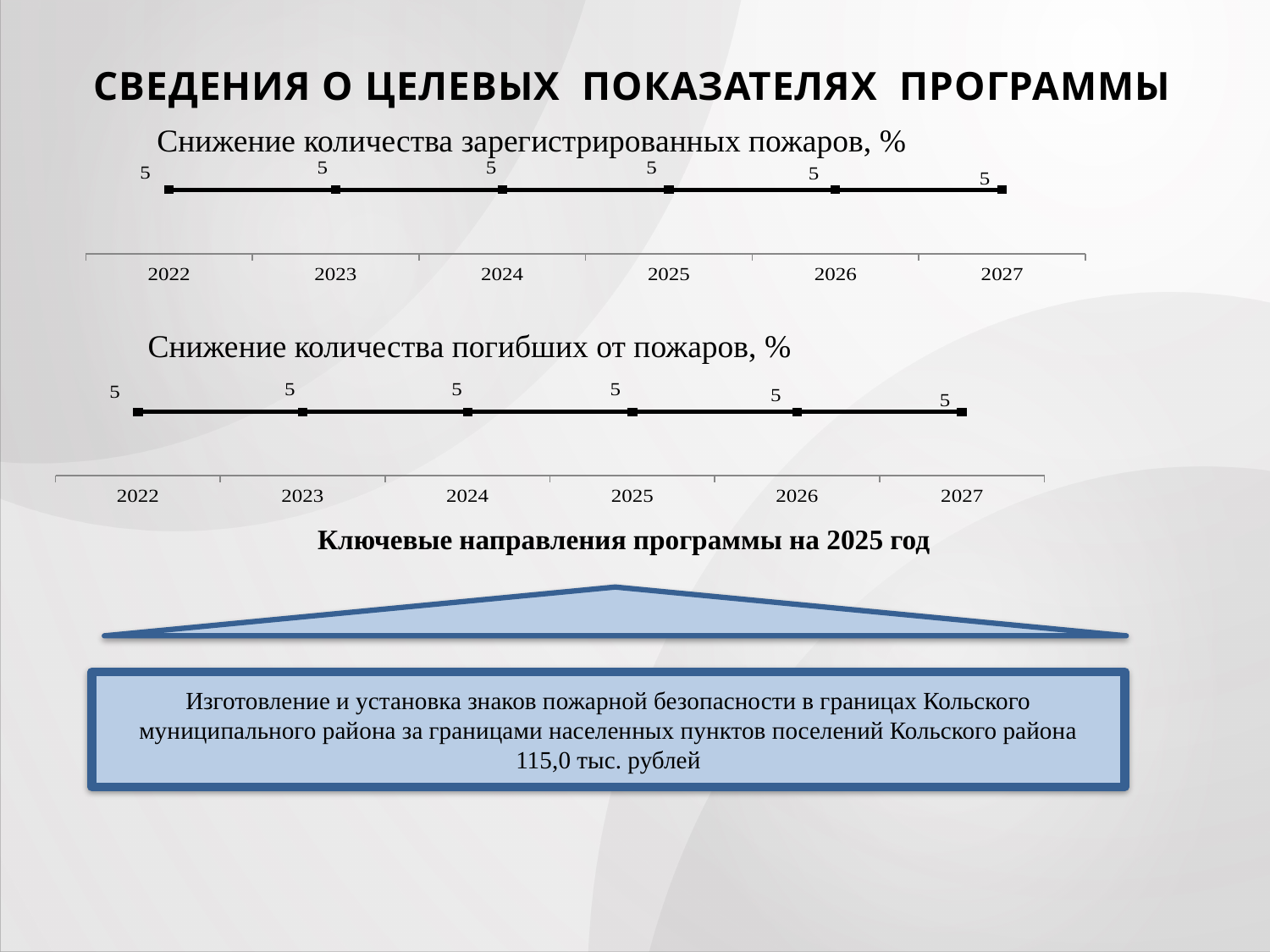
In the top chart ("Снижение количества зарегистрированных пожаров, %"), what is the value for 2022? 5 In the bottom chart ("Снижение количества погибших от пожаров, %"), what is the value for 2025? 5 In the bottom chart ("Снижение количества погибших от пожаров, %"), what is the difference between the values for 2023 and 2026? 0 How many years are shown on the x axis of the chart titled "Снижение количества погибших от пожаров, %"? 6 In the top chart ("Снижение количества зарегистрированных пожаров, %"), what is the difference between the values for 2027 and 2022? 0 In the chart titled "Снижение количества зарегистрированных пожаров, %", what is the value for 2024? 5 What is the first year shown on the x axis of the bottom chart, "Снижение количества погибших от пожаров, %"? 2022 How many data points are plotted in the chart titled "Снижение количества зарегистрированных пожаров, %"? 6 Do the values in the chart titled "Снижение количества погибших от пожаров, %" rise, fall, or stay flat from 2022 to 2027? stay flat What kind of chart is the top chart, "Снижение количества зарегистрированных пожаров, %"? line chart In the chart titled "Снижение количества погибших от пожаров, %", what is the value for 2027? 5 What is the title of the top chart on the slide? Снижение количества зарегистрированных пожаров, %